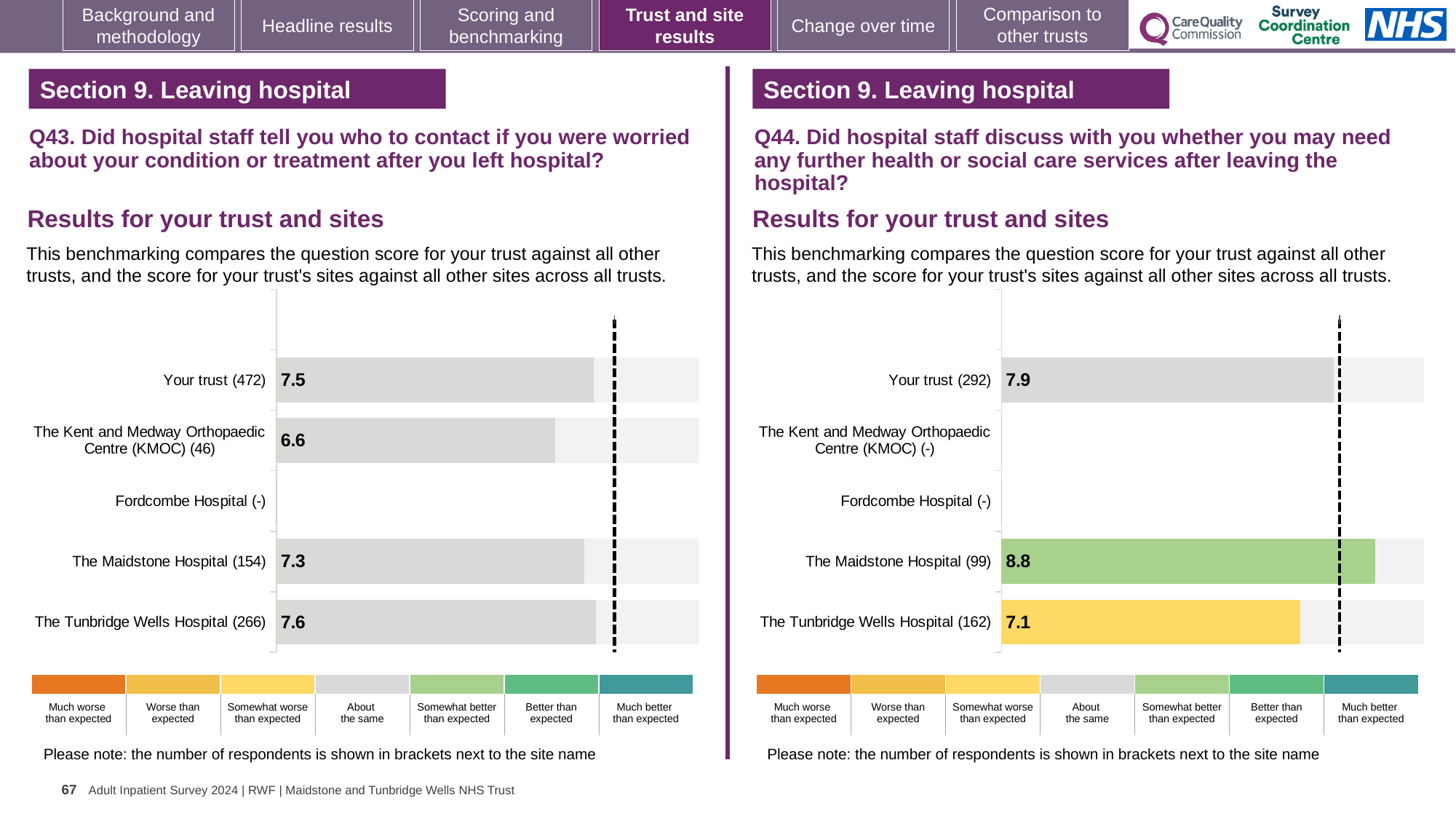
On the Q44 chart (right), what is the difference between the scores for The Maidstone Hospital (99) and Your trust (292)? 0.9 On the Q43 chart (left), which site has the lowest score? The Kent and Medway Orthopaedic Centre (KMOC) (46) On the Q43 chart (left), what is the score for The Kent and Medway Orthopaedic Centre (KMOC) (46)? 6.6 What kind of chart is used on the Q43 chart (left)? Bar chart On the Q43 chart (left), what is the difference between the scores for The Tunbridge Wells Hospital (266) and The Maidstone Hospital (154)? 0.3 On the Q44 chart (right), which site has the highest score? The Maidstone Hospital (99) On the Q43 chart (left), which bar has the highest score? The Tunbridge Wells Hospital (266) On the Q44 chart (right), what is the score for The Tunbridge Wells Hospital (162)? 7.1 On the Q44 chart (right), what colour is the bar for The Tunbridge Wells Hospital (162)? Yellow On the Q43 chart (left), what is the score for Your trust (472)? 7.5 On the Q44 chart (right), what is the score for The Maidstone Hospital (99)? 8.8 On the Q44 chart (right), which is larger: the score for Your trust (292) or The Tunbridge Wells Hospital (162)? Your trust (292)